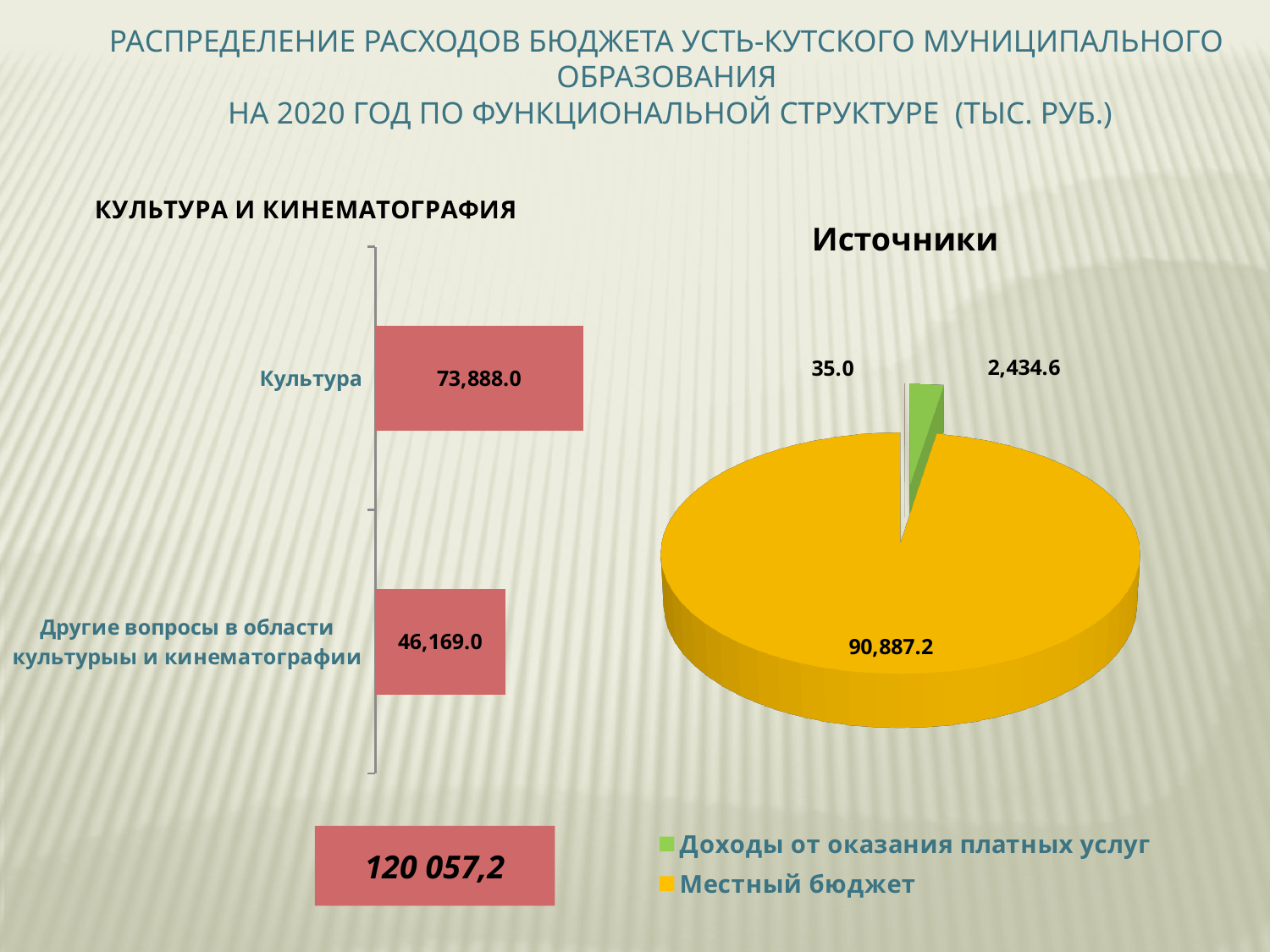
What kind of chart is the chart titled Источники on the right of the slide? pie chart In the bar chart titled КУЛЬТУРА И КИНЕМАТОГРАФИЯ, how many bars are plotted? 2 How many entries does the legend of the pie chart titled Источники list? 2 In the pie chart titled Источники, what is the value for Местный бюджет? 90,887.2 In the bar chart titled КУЛЬТУРА И КИНЕМАТОГРАФИЯ, what is the value for Культура? 73,888.0 In the bar chart titled КУЛЬТУРА И КИНЕМАТОГРАФИЯ, which category has the highest value? Культура In the pie chart titled Источники, what colour is the slice for Местный бюджет? yellow In the pie chart titled Источники, which is larger: Местный бюджет or Доходы от оказания платных услуг? Местный бюджет In the bar chart titled КУЛЬТУРА И КИНЕМАТОГРАФИЯ, what is the value for Другие вопросы в области культурыы и кинематографии? 46,169.0 What kind of chart is the chart titled КУЛЬТУРА И КИНЕМАТОГРАФИЯ on the left of the slide? bar chart In the bar chart titled КУЛЬТУРА И КИНЕМАТОГРАФИЯ, which category has the lowest value? Другие вопросы в области культурыы и кинематографии In the bar chart titled КУЛЬТУРА И КИНЕМАТОГРАФИЯ, what is the difference between the value for Культура and the value for Другие вопросы в области культурыы и кинематографии? 27,719.0